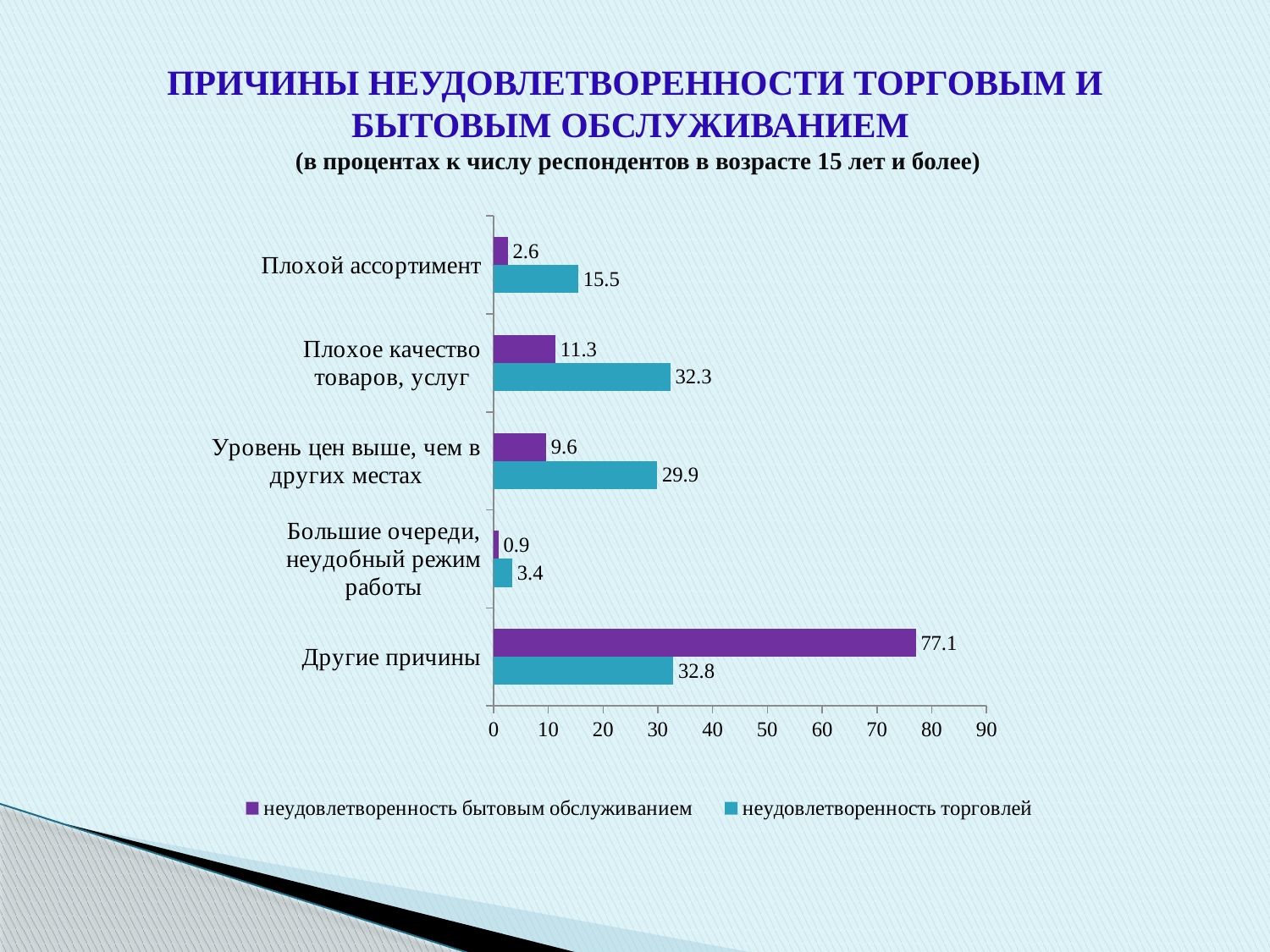
What colour represents the series «неудовлетворенность торговлей»? blue Is the value for «Другие причины» in the series «неудовлетворенность бытовым обслуживанием» greater or less than 70? greater What is the value for «Другие причины» in the series «неудовлетворенность бытовым обслуживанием»? 77.1 What is the difference between the two series for «Плохое качество товаров, услуг»? 21.0 How many series does the legend list? 2 What is the value for «Уровень цен выше, чем в других местах» in the series «неудовлетворенность бытовым обслуживанием»? 9.6 Which category has the highest value in the series «неудовлетворенность торговлей»? Другие причины What is the value for «Плохой ассортимент» in the series «неудовлетворенность торговлей»? 15.5 For «Большие очереди, неудобный режим работы», which series has the larger value? неудовлетворенность торговлей What kind of chart is shown on the slide? bar chart How many categories are shown on the chart? 5 Which category has the lowest value in the series «неудовлетворенность бытовым обслуживанием»? Большие очереди, неудобный режим работы